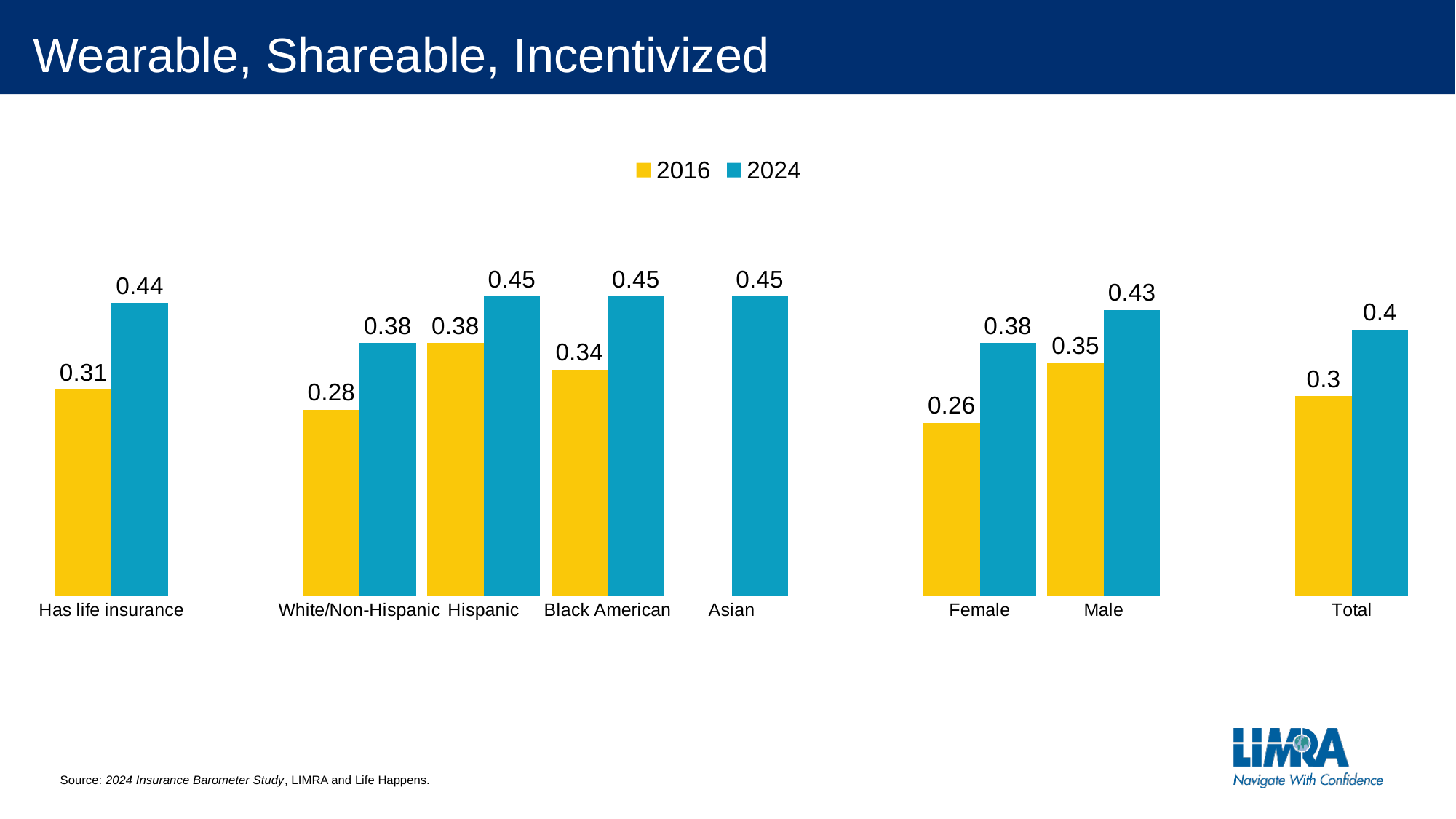
What kind of chart is shown on the slide? Bar chart What is the 2024 value for Has life insurance? 0.44 What is the difference between the 2024 and 2016 values for Male? 0.08 Which category has only a 2024 bar and no 2016 bar? Asian Which category has the highest 2016 value? Hispanic Which category has the lowest 2016 value? Female What is the 2016 value for Black American? 0.34 How many series does the legend list? 2 Which is larger, the 2016 value for Male or the 2016 value for Hispanic? Hispanic What is the difference between the 2024 and 2016 values for Has life insurance? 0.13 What is the 2016 value for Female? 0.26 What is the 2024 value for Total? 0.4